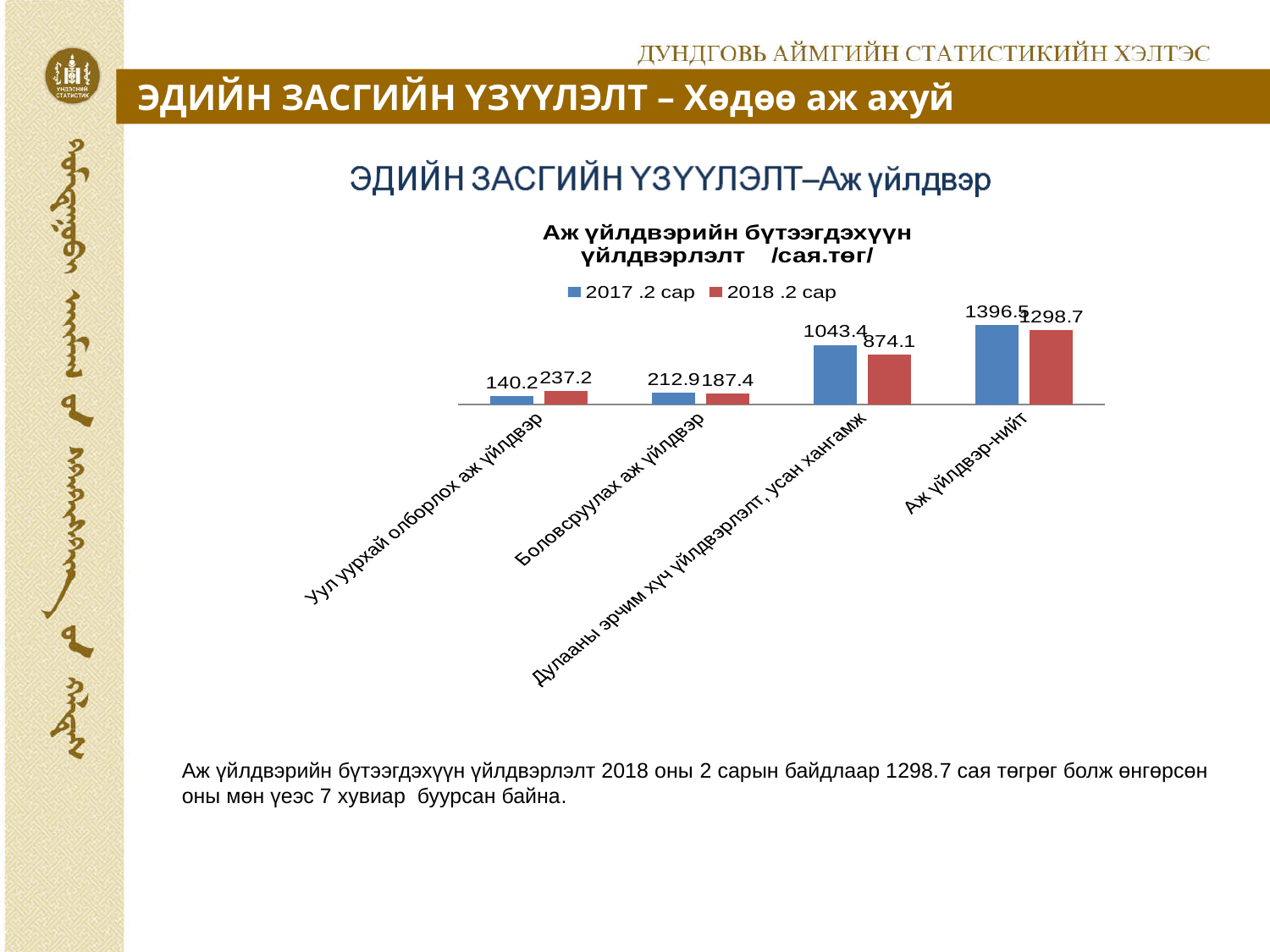
How many series does the legend list? 2 Which category has the highest value in the 2018 .2 сар series? Аж үйлдвэр-нийт What is the value for Боловсруулах аж үйлдвэр in the 2017 .2 сар series? 212.9 What is the difference between the 2017 .2 сар and 2018 .2 сар values for Аж үйлдвэр-нийт? 97.8 What is the value for Дулааны эрчим хүч үйлдвэрлэлт, усан хангамж in the 2018 .2 сар series? 874.1 What is the value for Уул уурхай олборлох аж үйлдвэр in the 2018 .2 сар series? 237.2 What is the value for Аж үйлдвэр-нийт in the 2017 .2 сар series? 1396.5 Which category has the lowest value in the 2017 .2 сар series? Уул уурхай олборлох аж үйлдвэр For Боловсруулах аж үйлдвэр, which series has the larger value, 2017 .2 сар or 2018 .2 сар? 2017 .2 сар What kind of chart is shown on the slide? Bar chart How many categories are shown on the x axis of the chart? 4 What is the value for Уул уурхай олборлох аж үйлдвэр in the 2017 .2 сар series? 140.2